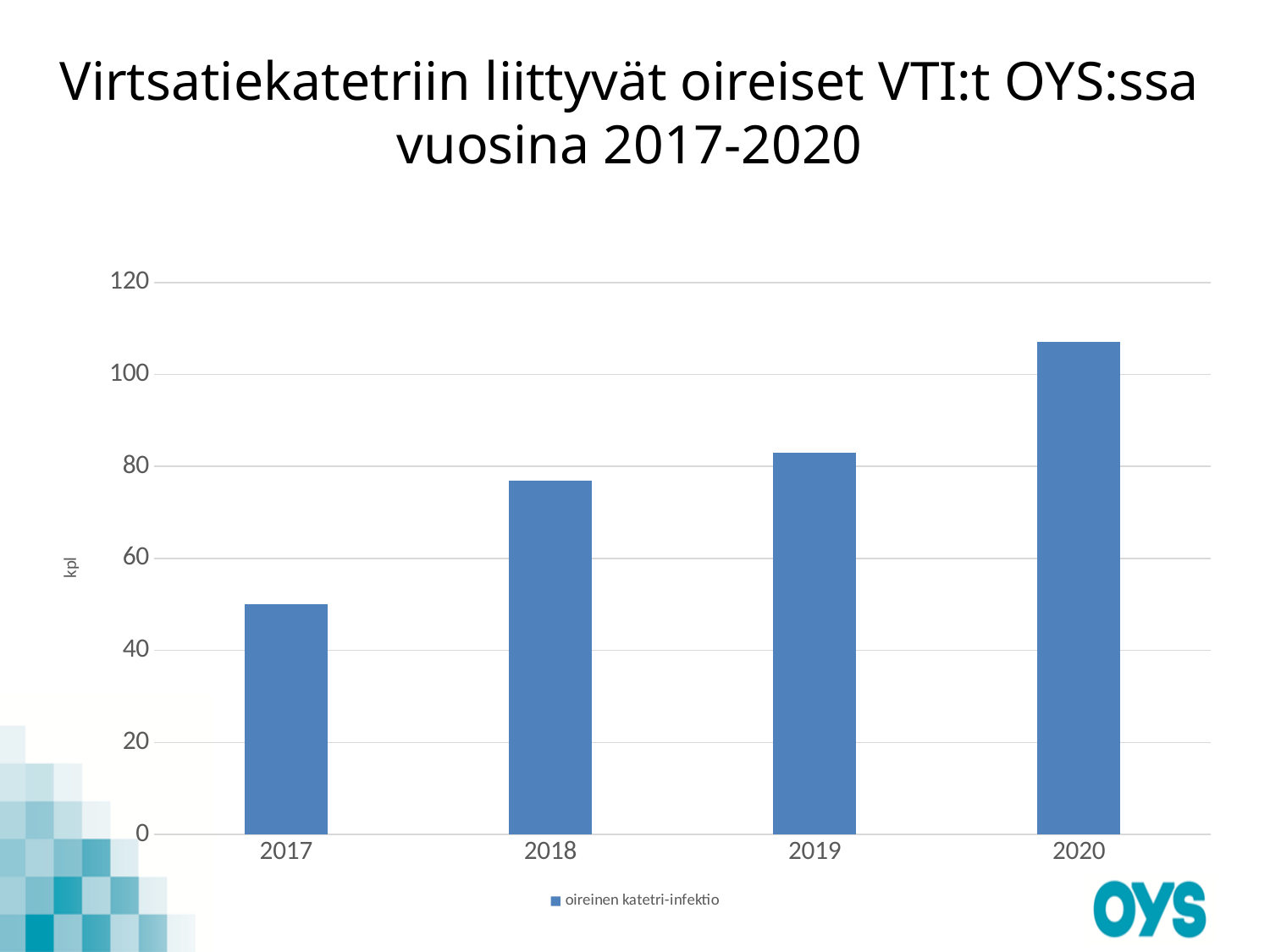
How many years (categories) are shown on the x axis? 4 Is the value for 2020 greater or less than 100? greater Which year has the larger value, 2018 or 2019? 2019 What kind of chart is shown on the slide? bar chart Do the values rise or fall from 2017 to 2020? rise How many series does the legend list? 1 Which year has the highest number of symptomatic catheter infections? 2020 Which year has the lowest number of symptomatic catheter infections? 2017 Is the value for 2017 greater or less than 60? less Is the value for 2017 greater or less than 40? greater What is the label of the series shown in the legend? oireinen katetri-infektio